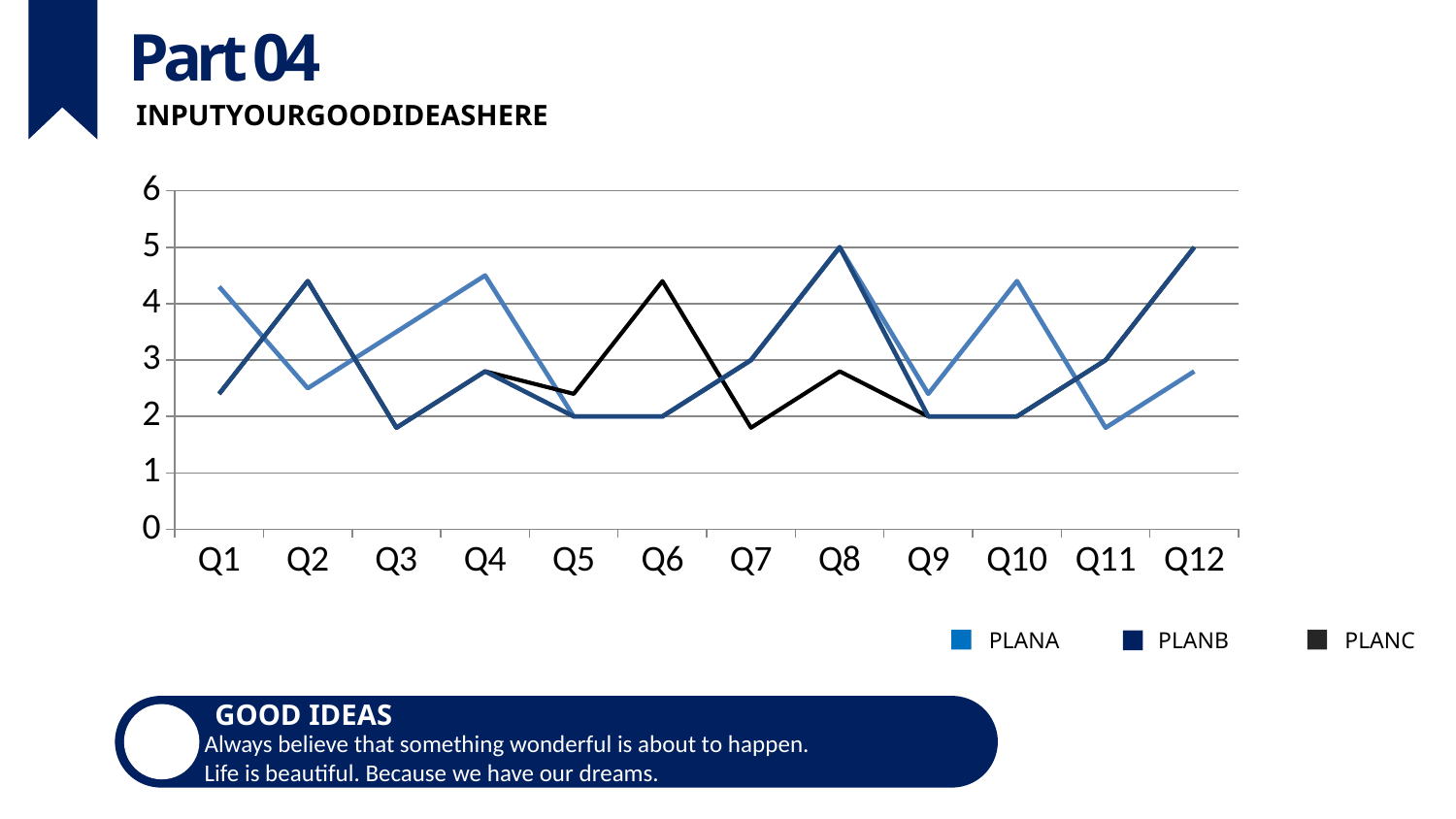
At Q10, which series has the larger value, PLANA or PLANB? PLANA Does the PLANB line rise or fall from Q10 to Q12? rise How many quarters are plotted along the x axis? 12 What kind of chart is shown on the slide? line chart How many series does the legend list? 3 Is the value for PLANA at Q1 greater or less than 4? greater Which series is shown in black in the legend? PLANC Is the value for PLANA at Q11 greater or less than 2? less At Q2, which series has the larger value, PLANA or PLANB? PLANB Is the value for PLANB at Q3 greater or less than 2? less